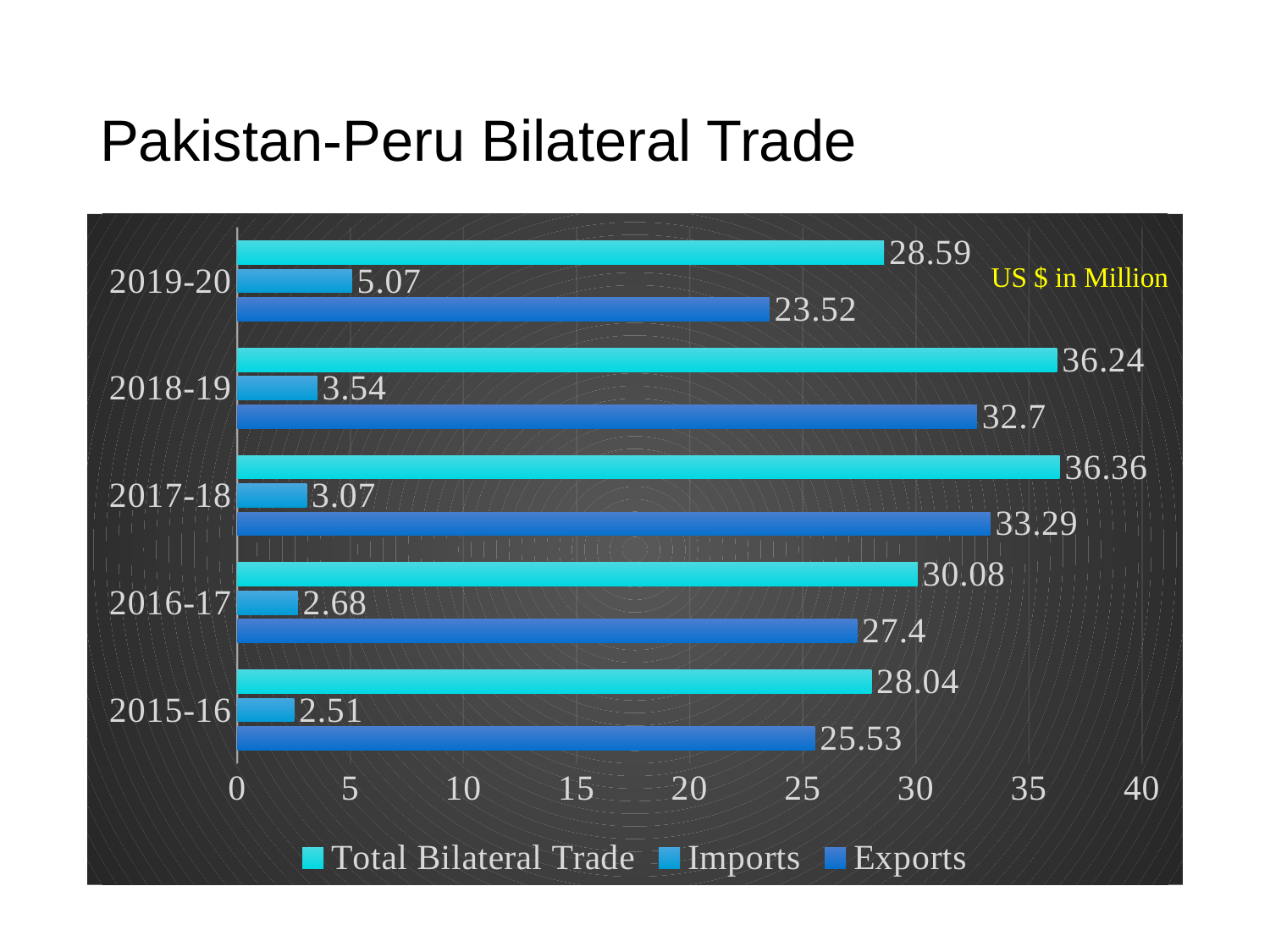
How many series does the legend list? 3 In which year were Imports lowest? 2015-16 What kind of chart is shown on the slide? bar chart What was the value of Imports in 2019-20? 5.07 What unit is stated for the values on the chart? US $ in Million What was the value of Exports in 2015-16? 25.53 In which year were Exports highest? 2017-18 Which was larger in 2016-17, Exports or Imports? Exports How many years are shown on the chart? 5 What is the difference between Exports and Imports in 2018-19? 29.16 What was the Total Bilateral Trade in 2017-18? 36.36 Is the Total Bilateral Trade for 2019-20 greater or less than 30? less